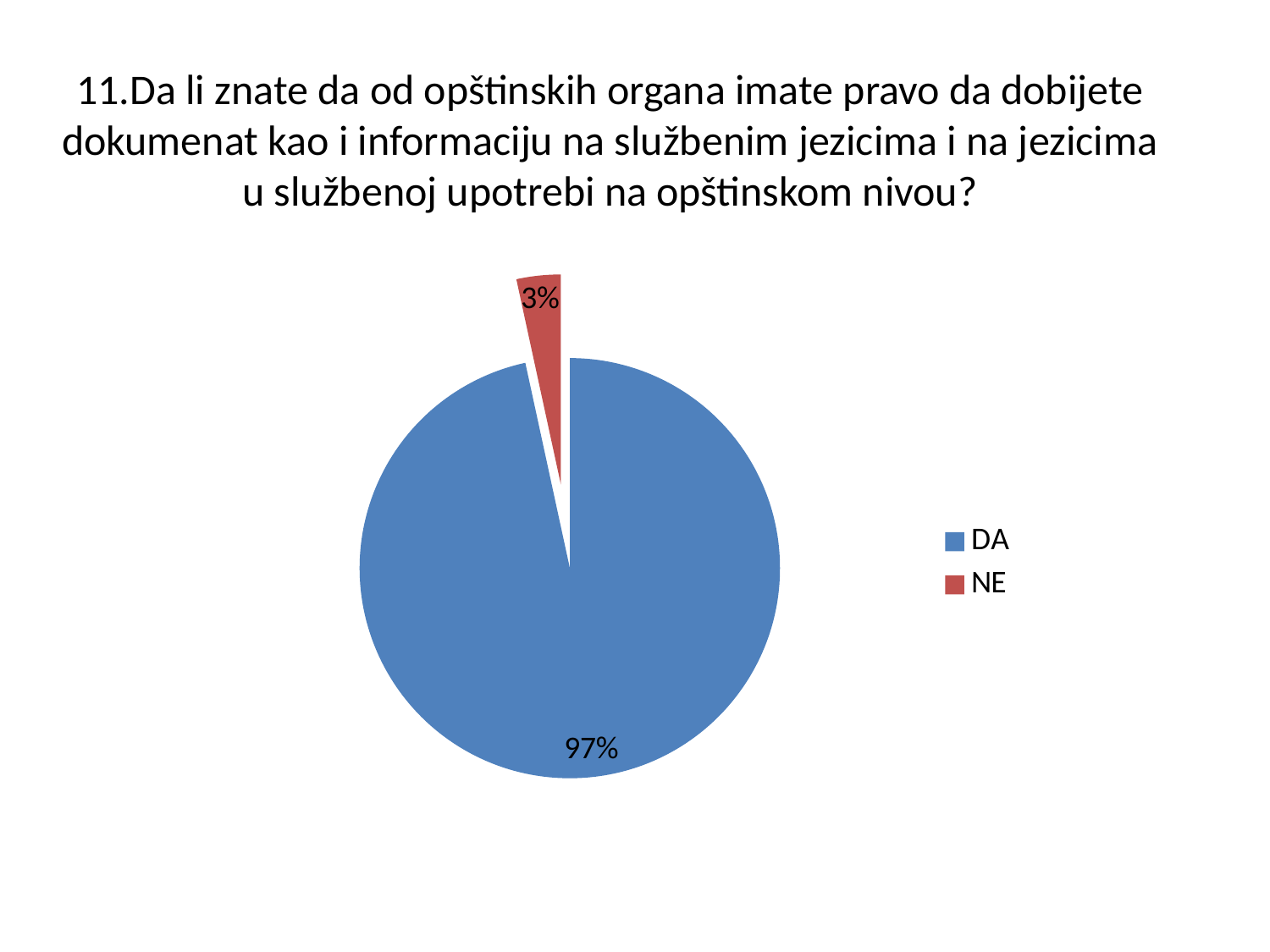
What type of chart is shown on the slide? pie chart How many entries does the legend list? 2 What is the difference in percentage points between the DA and NE slices? 94 How many categories does the pie chart show? 2 Which is larger, the DA slice or the NE slice? DA Which category has the smallest slice of the pie? NE What share of the pie does DA represent? 97% What colour is the NE slice? red What share of the pie does NE represent? 3% Which category has the largest slice of the pie? DA What colour is the DA slice? blue